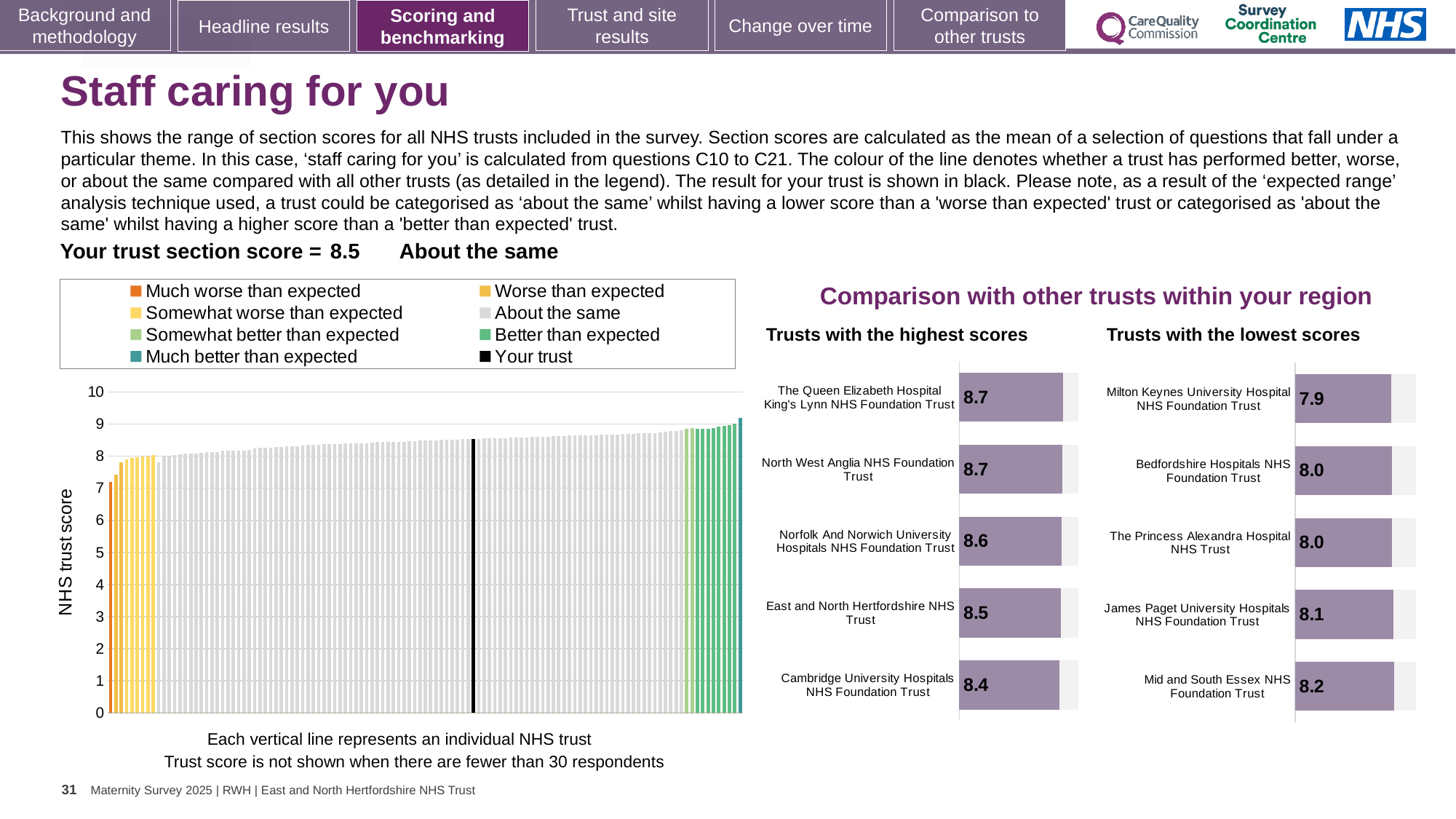
In the 'Trusts with the highest scores' chart, what is the score for Norfolk And Norwich University Hospitals NHS Foundation Trust? 8.6 Which is larger: the score for East and North Hertfordshire NHS Trust in the highest scores chart or the score for Mid and South Essex NHS Foundation Trust in the lowest scores chart? East and North Hertfordshire NHS Trust In the 'Trusts with the lowest scores' chart, what is the score for Milton Keynes University Hospital NHS Foundation Trust? 7.9 How many entries does the legend of the main 'NHS trust score' chart on the left list? 8 In the 'Trusts with the highest scores' chart, which trust has the lowest score? Cambridge University Hospitals NHS Foundation Trust In the 'Trusts with the highest scores' chart, what is the score for Cambridge University Hospitals NHS Foundation Trust? 8.4 In the 'Trusts with the lowest scores' chart, what is the score for James Paget University Hospitals NHS Foundation Trust? 8.1 In the 'Trusts with the highest scores' chart, how many trusts are shown? 5 In the main 'NHS trust score' chart on the left, is the value for the black 'Your trust' bar greater or less than 8? greater In the 'Trusts with the lowest scores' chart, which trust has the highest score? Mid and South Essex NHS Foundation Trust In the 'Trusts with the lowest scores' chart, which trust has the lowest score? Milton Keynes University Hospital NHS Foundation Trust What is the difference between the score for The Queen Elizabeth Hospital King's Lynn NHS Foundation Trust in the highest scores chart and the score for Milton Keynes University Hospital NHS Foundation Trust in the lowest scores chart? 0.8